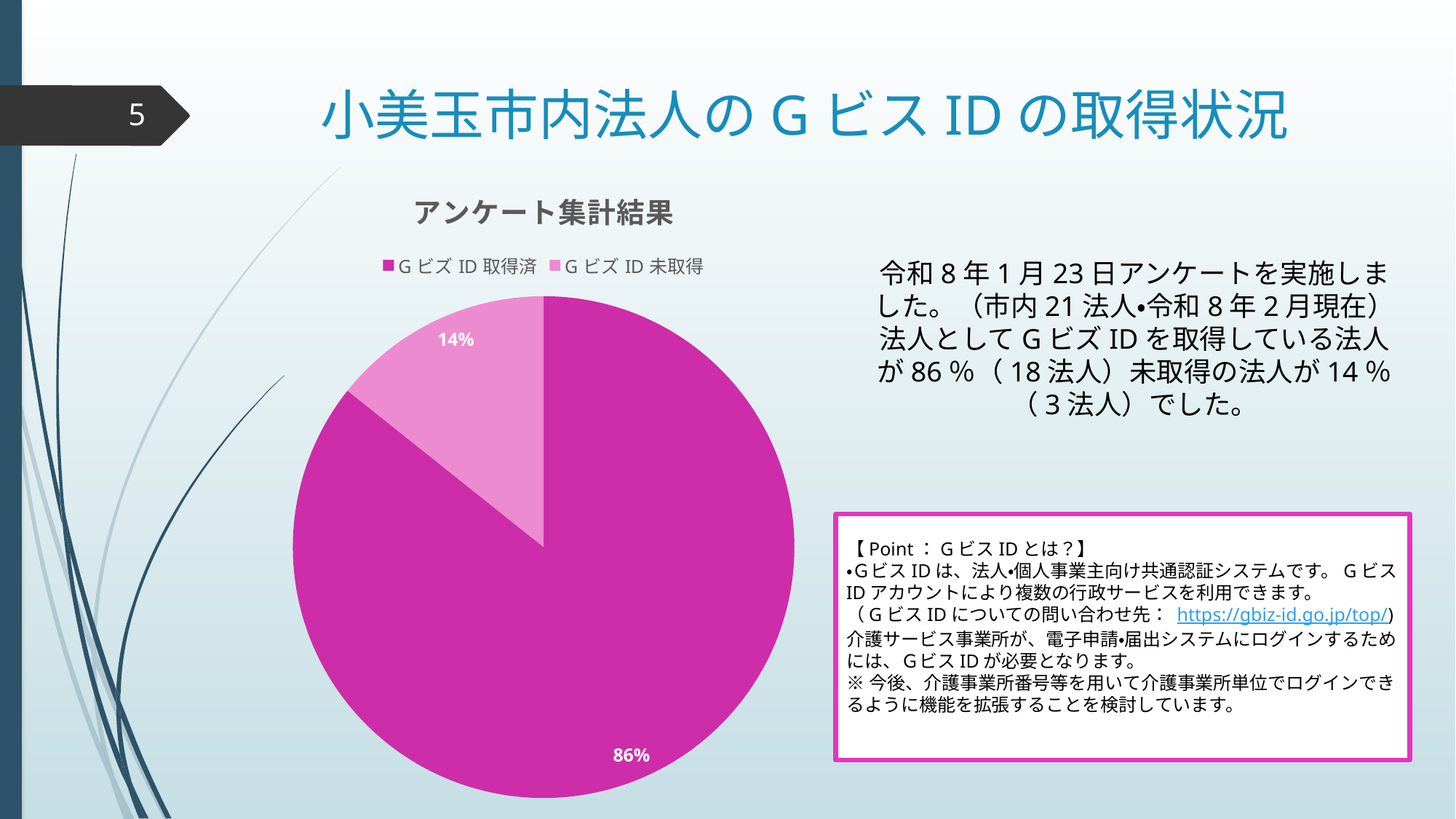
What is the difference in percentage points between Gビズ ID 取得済 and Gビズ ID 未取得? 72 How many categories does the pie chart show? 2 How many entries does the legend list? 2 Which is larger, the slice for Gビズ ID 取得済 or the slice for Gビズ ID 未取得? Gビズ ID 取得済 What share of the pie does Gビズ ID 取得済 represent? 86% Which category has the largest slice of the pie? Gビズ ID 取得済 What type of chart is shown on the slide? pie chart What share of the pie does Gビズ ID 未取得 represent? 14% What is the title of the chart? アンケート集計結果 Which category is shown in the lighter pink colour? Gビズ ID 未取得 Which category has the smallest slice of the pie? Gビズ ID 未取得